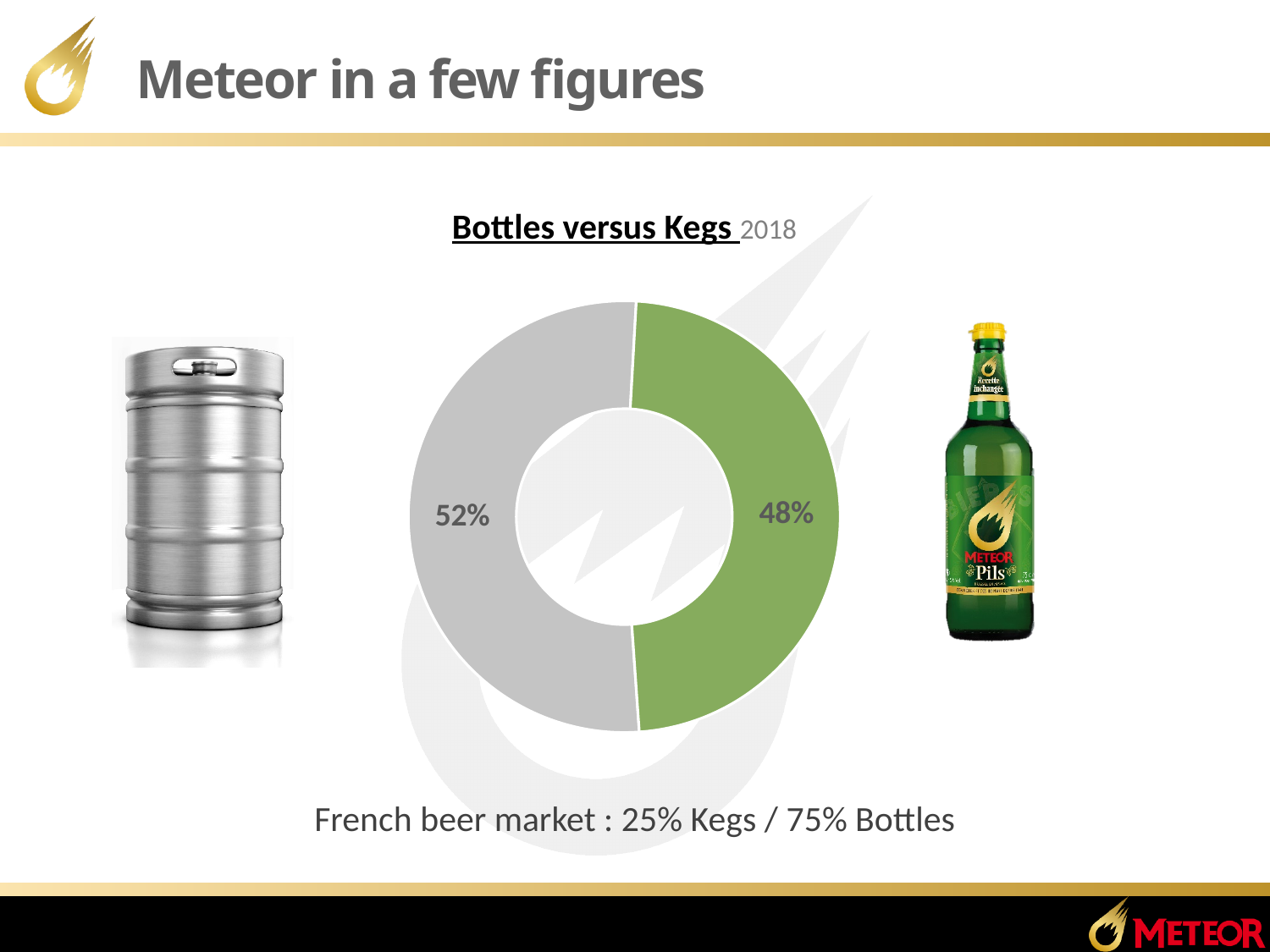
What is the share of the donut chart taken by the grey slice? 52% What percentage is shown on the grey slice of the donut chart? 52% What is the difference in percentage points between the grey slice and the green slice? 4 percentage points Is the value of the green slice greater or less than 50%? less What is the title of the chart? Bottles versus Kegs 2018 Is the value of the grey slice greater or less than 50%? greater Which slice of the donut chart is larger, the grey one or the green one? The grey one What year does the chart title refer to? 2018 What kind of chart is shown on the slide? Donut (pie) chart How many slices does the donut chart have? 2 What is the share of the donut chart taken by the green slice? 48% What percentage is shown on the green slice of the donut chart? 48%